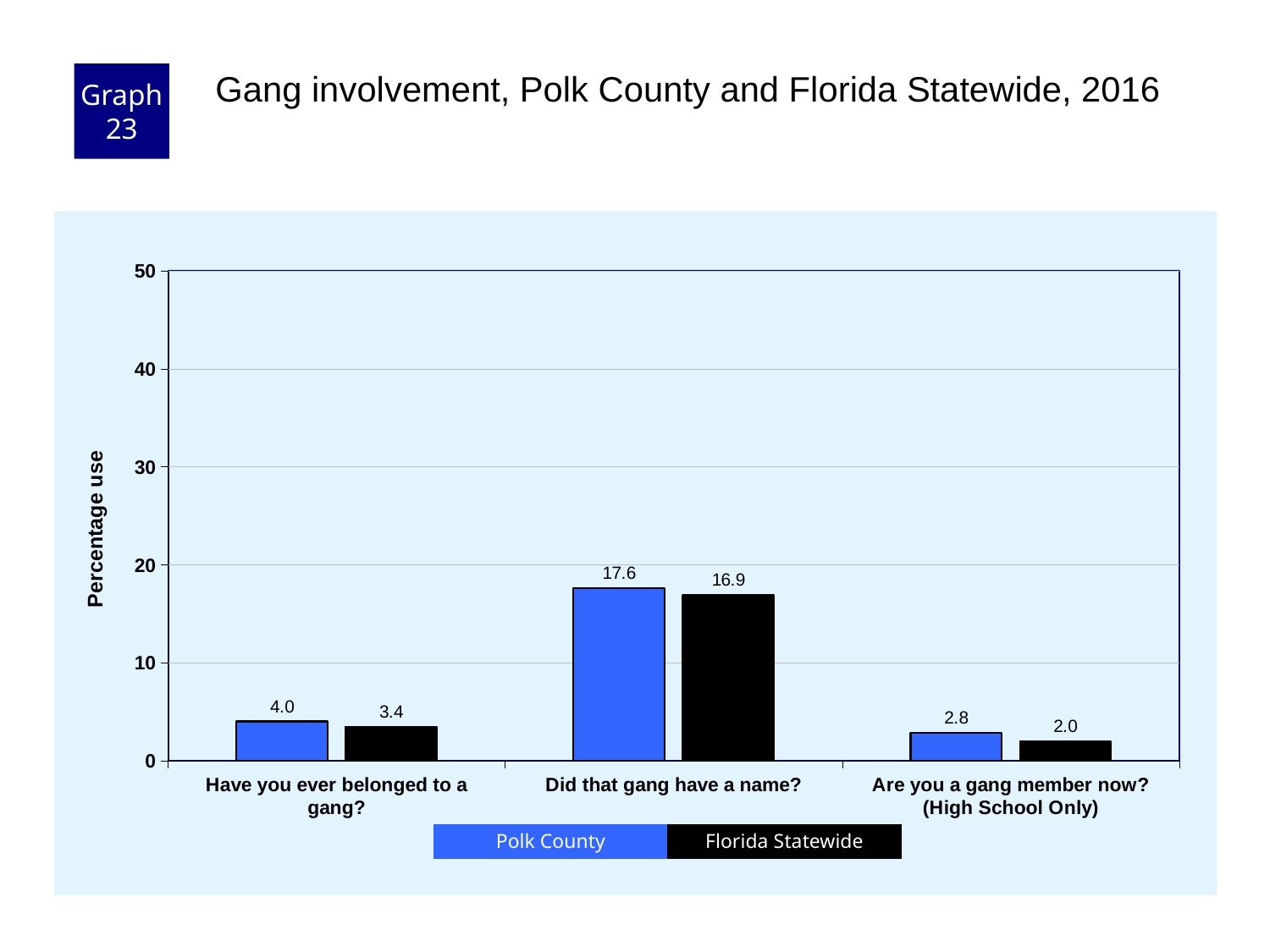
What is the Polk County value for "Did that gang have a name?"? 17.6 What is the Florida Statewide value for "Are you a gang member now? (High School Only)"? 2.0 What is the Florida Statewide value for "Have you ever belonged to a gang?"? 3.4 Is the Polk County value for "Did that gang have a name?" greater or less than 20? less Which question has the highest Polk County value? Did that gang have a name? What kind of chart is shown on the slide? Bar chart For "Have you ever belonged to a gang?", which is larger: Polk County or Florida Statewide? Polk County How many questions (categories) are shown on the x axis? 3 What is the label of the y axis? Percentage use How many series does the legend list? 2 Which question has the lowest Florida Statewide value? Are you a gang member now? (High School Only) What is the difference between the Polk County and Florida Statewide values for "Did that gang have a name?"? 0.7